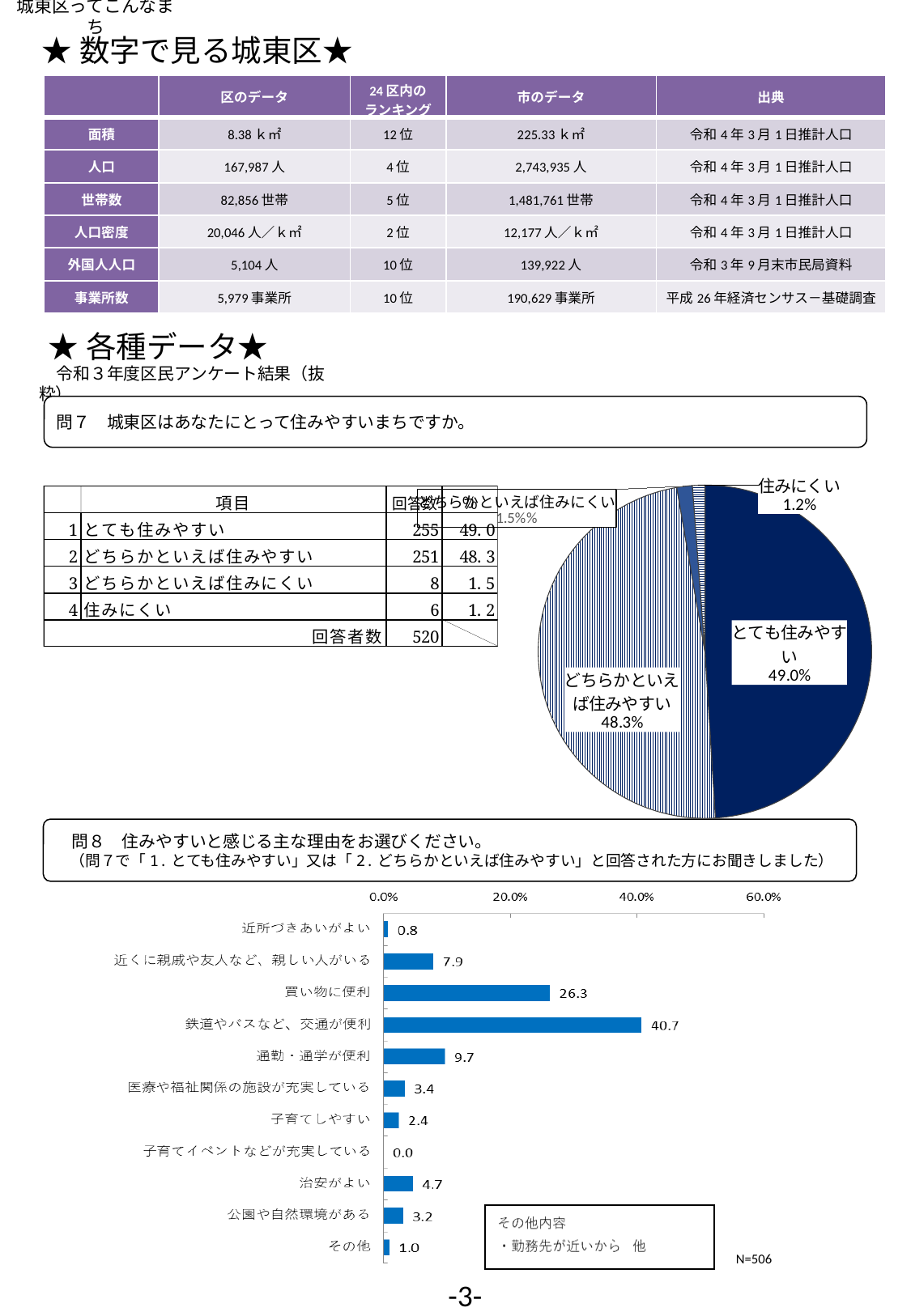
In the bar chart for 問8, which is larger: 通勤・通学が便利 or 治安がよい? 通勤・通学が便利 In the bar chart for 問8, which reason has the highest value? 鉄道やバスなど、交通が便利 In the pie chart for 問7, how many slices are there? 4 What kind of chart is used for 問7? Pie chart In the bar chart for 問8, what is the value for 鉄道やバスなど、交通が便利? 40.7 In the pie chart for 問7, what share of respondents answered とても住みやすい? 49.0% In the pie chart for 問7, which response has the smallest slice? 住みにくい In the bar chart for 問8, how many reason categories are plotted? 11 In the pie chart for 問7, what share of respondents answered どちらかといえば住みやすい? 48.3% In the pie chart for 問7, what is the difference in percentage points between とても住みやすい and どちらかといえば住みやすい? 0.7 In the bar chart for 問8, which reason has the lowest value? 子育てイベントなどが充実している In the bar chart for 問8, what is the value for 買い物に便利? 26.3